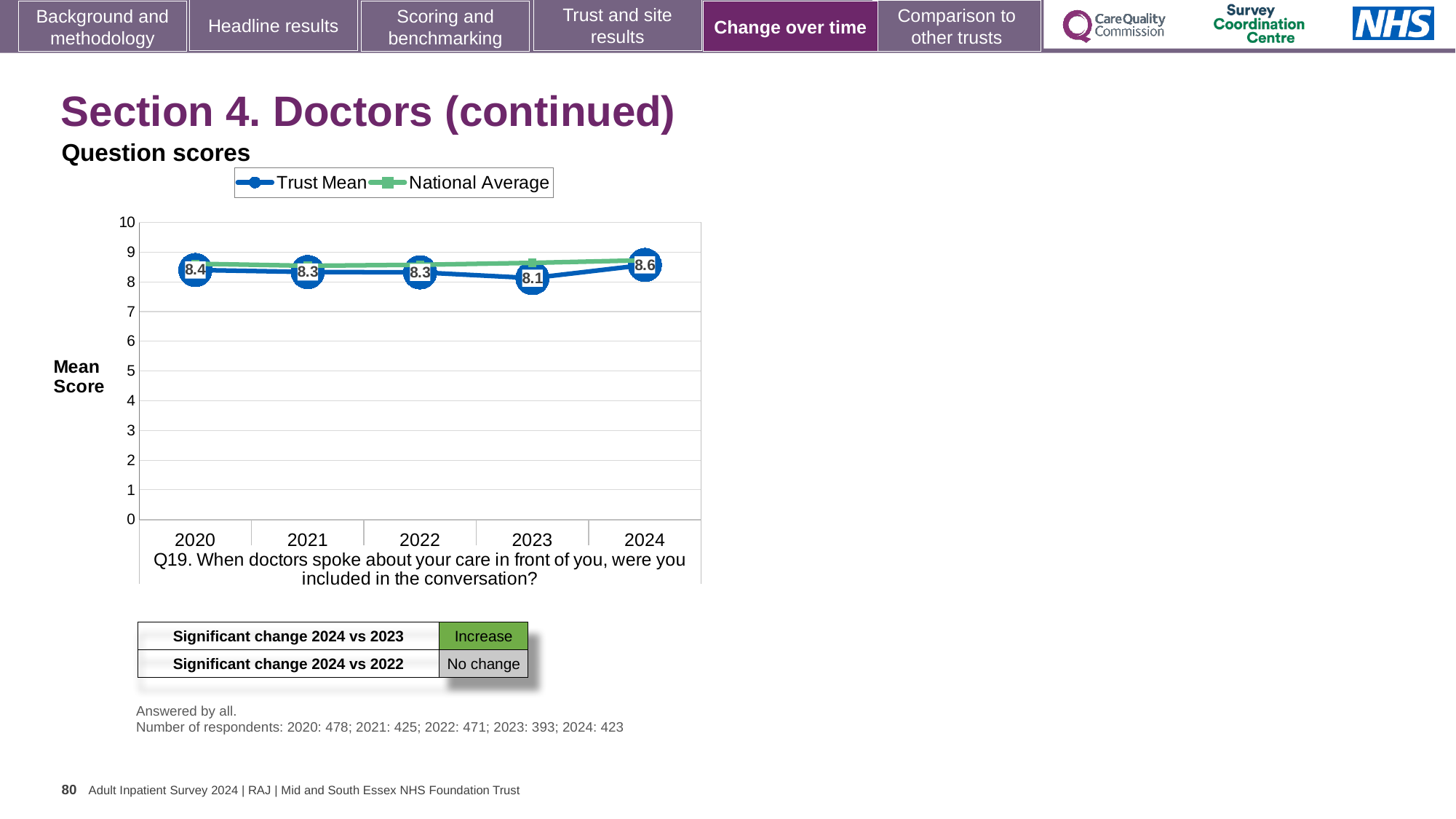
What is the difference between the Trust Mean scores for 2024 and 2023? 0.5 How many series does the legend list? 2 What is the Trust Mean score for 2020? 8.4 What kind of chart is shown? Line chart What is the Trust Mean score for 2023? 8.1 In which year is the Trust Mean score highest? 2024 What is the Trust Mean score for 2024? 8.6 Which is larger, the Trust Mean score for 2020 or for 2023? 2020 Is the National Average value for 2024 greater or less than 8? greater How many years are shown on the x axis? 5 In which year is the Trust Mean score lowest? 2023 Does the Trust Mean score rise or fall from 2023 to 2024? Rise